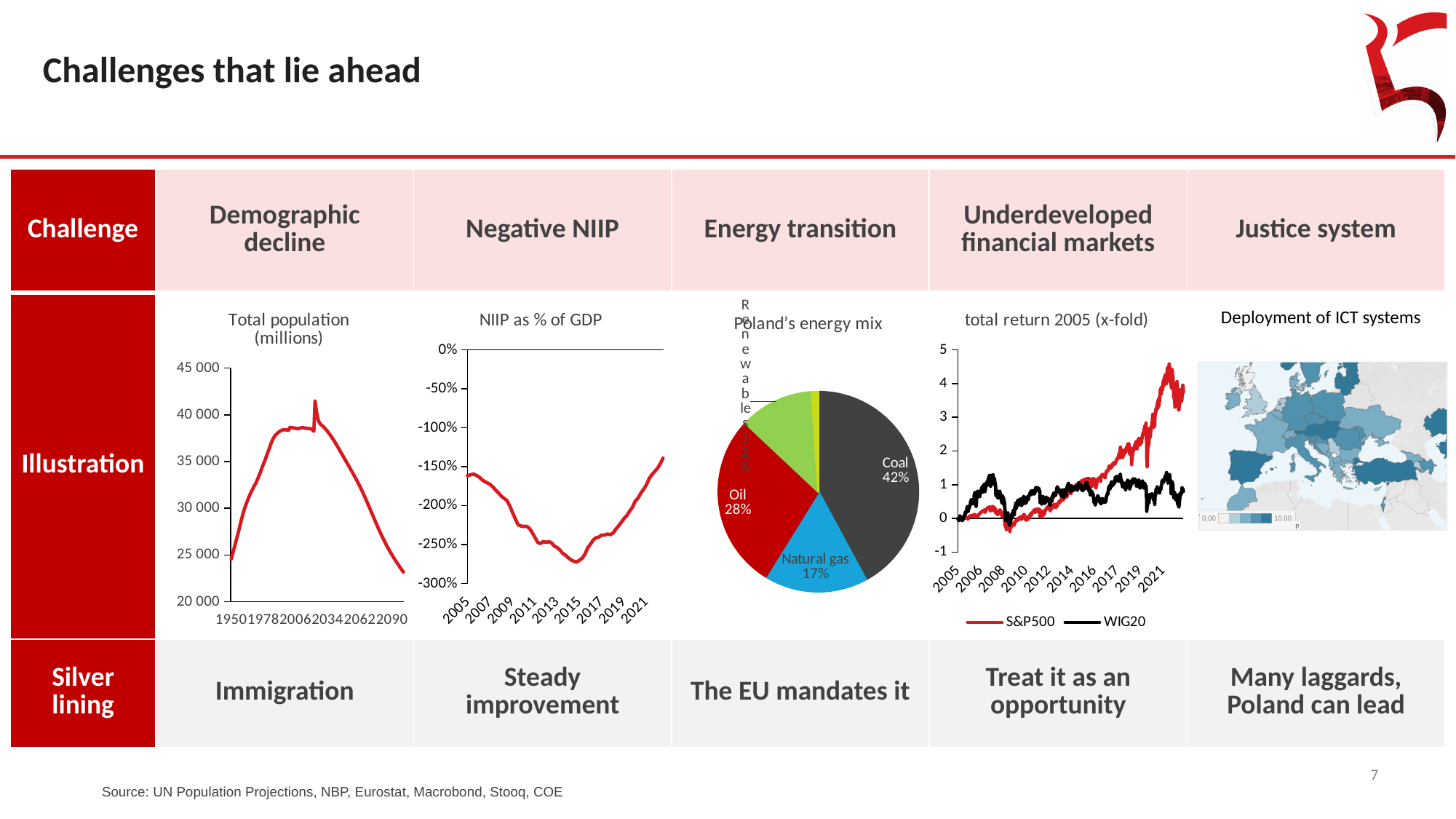
In the 'Total population (millions)' chart, is the value for 2006 greater or less than 35 000? greater In the 'Poland's energy mix' pie chart, what share does Natural gas have? 17% In the 'Poland's energy mix' pie chart, which is larger, the Oil slice or the Natural gas slice? Oil In the 'total return 2005 (x-fold)' chart, which series is higher at the end of the period, S&P500 or WIG20? S&P500 In the 'Poland's energy mix' pie chart, which labelled slice is the largest? Coal What kind of chart is 'NIIP as % of GDP'? Line chart In the 'Poland's energy mix' pie chart, what share does Coal have? 42% What kind of chart is 'Poland's energy mix'? Pie chart In the 'Poland's energy mix' pie chart, how many percentage points larger is Coal's share than Oil's share? 14 In the 'NIIP as % of GDP' chart, is the value for 2015 greater or less than -250%? less How many series does the legend of the 'total return 2005 (x-fold)' chart list? 2